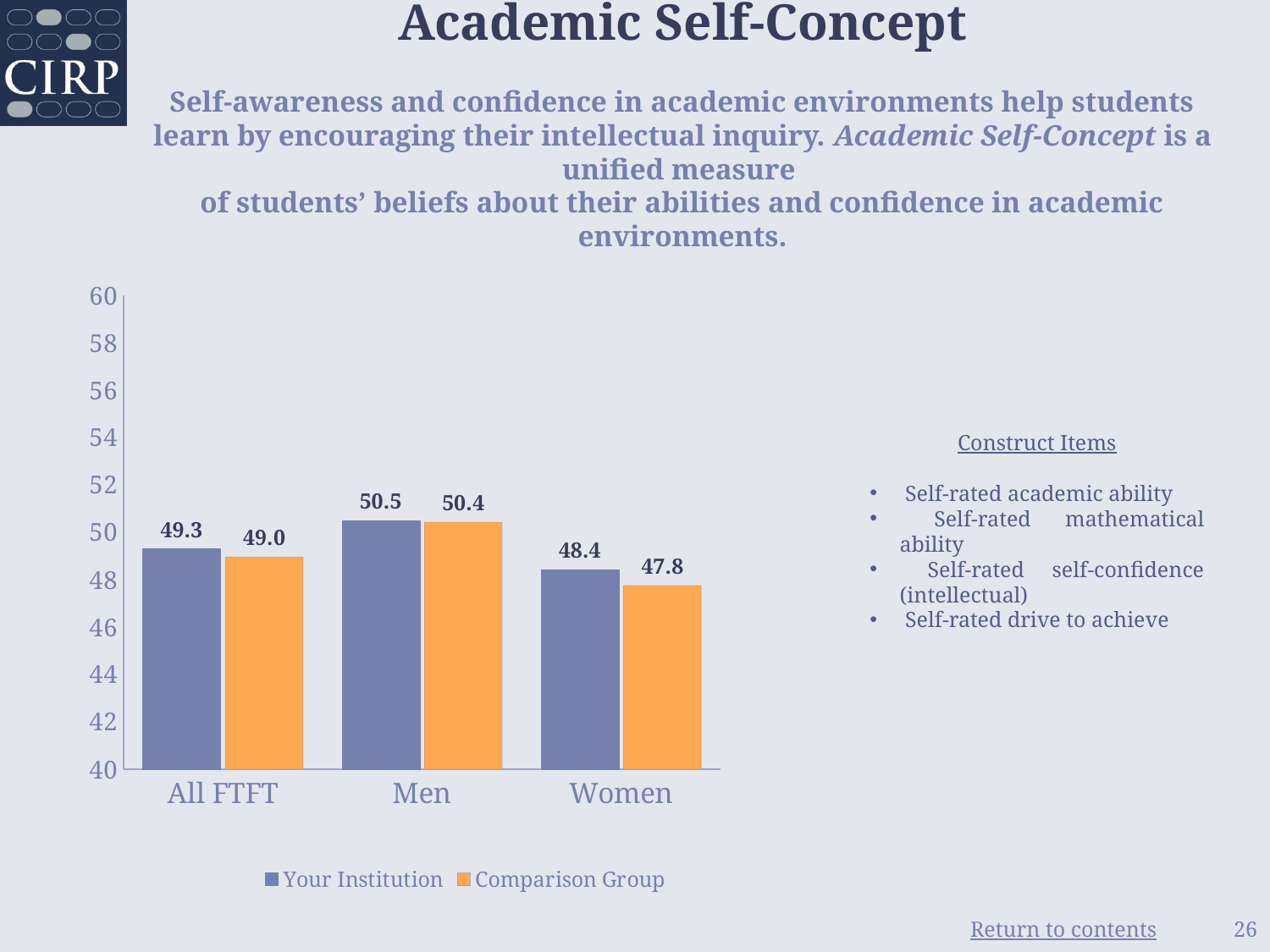
Is the Comparison Group value for Women greater or less than 48? less How many categories are shown on the x axis? 3 What is the value for Men in the Your Institution series? 50.5 How many series does the legend list? 2 What is the difference between Your Institution and Comparison Group for Women? 0.6 Which is larger for All FTFT: Your Institution or Comparison Group? Your Institution What is the value for Women in the Comparison Group series? 47.8 What is the difference between the Your Institution values for Men and Women? 2.1 What kind of chart is shown on the slide? bar chart Which category has the highest value in the Your Institution series? Men Which category has the lowest value in the Comparison Group series? Women What is the value for All FTFT in the Comparison Group series? 49.0